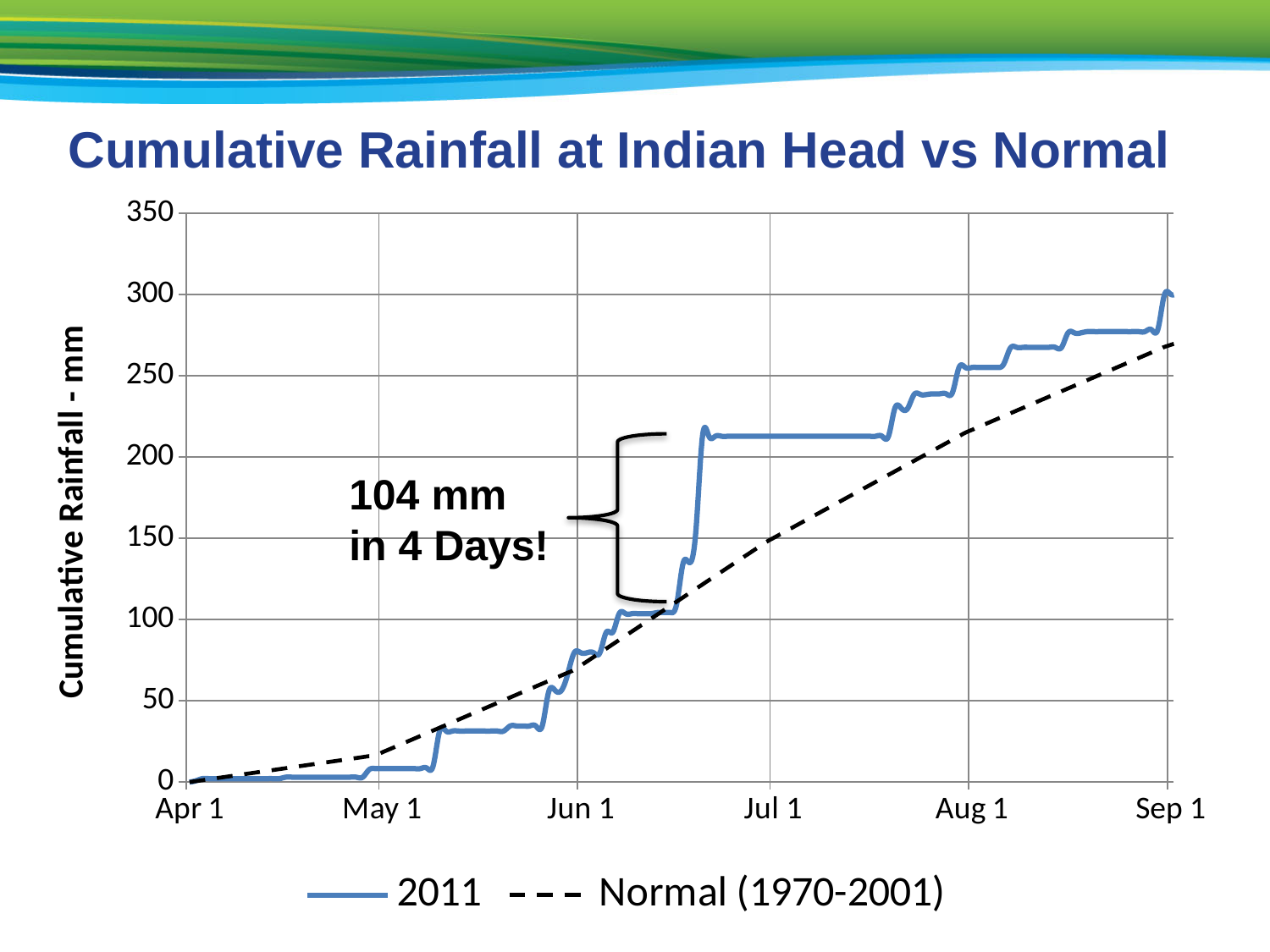
What kind of chart is shown on the slide? line chart Is the Normal (1970-2001) cumulative rainfall at Aug 1 greater or less than 250? less According to the annotation on the chart, how much rain fell in 4 days in 2011? 104 mm What is the title of the chart? Cumulative Rainfall at Indian Head vs Normal What are the two series named in the legend? 2011 and Normal (1970-2001) Is the Normal (1970-2001) cumulative rainfall at Sep 1 greater or less than 250? greater At May 1, which series has the higher cumulative rainfall, 2011 or Normal (1970-2001)? Normal (1970-2001) Is the 2011 cumulative rainfall at Jul 1 greater or less than 200? greater At Jul 1, which series has the higher cumulative rainfall, 2011 or Normal (1970-2001)? 2011 Does the 2011 cumulative rainfall line rise or fall from Apr 1 to Sep 1? rise How many series does the legend list? 2